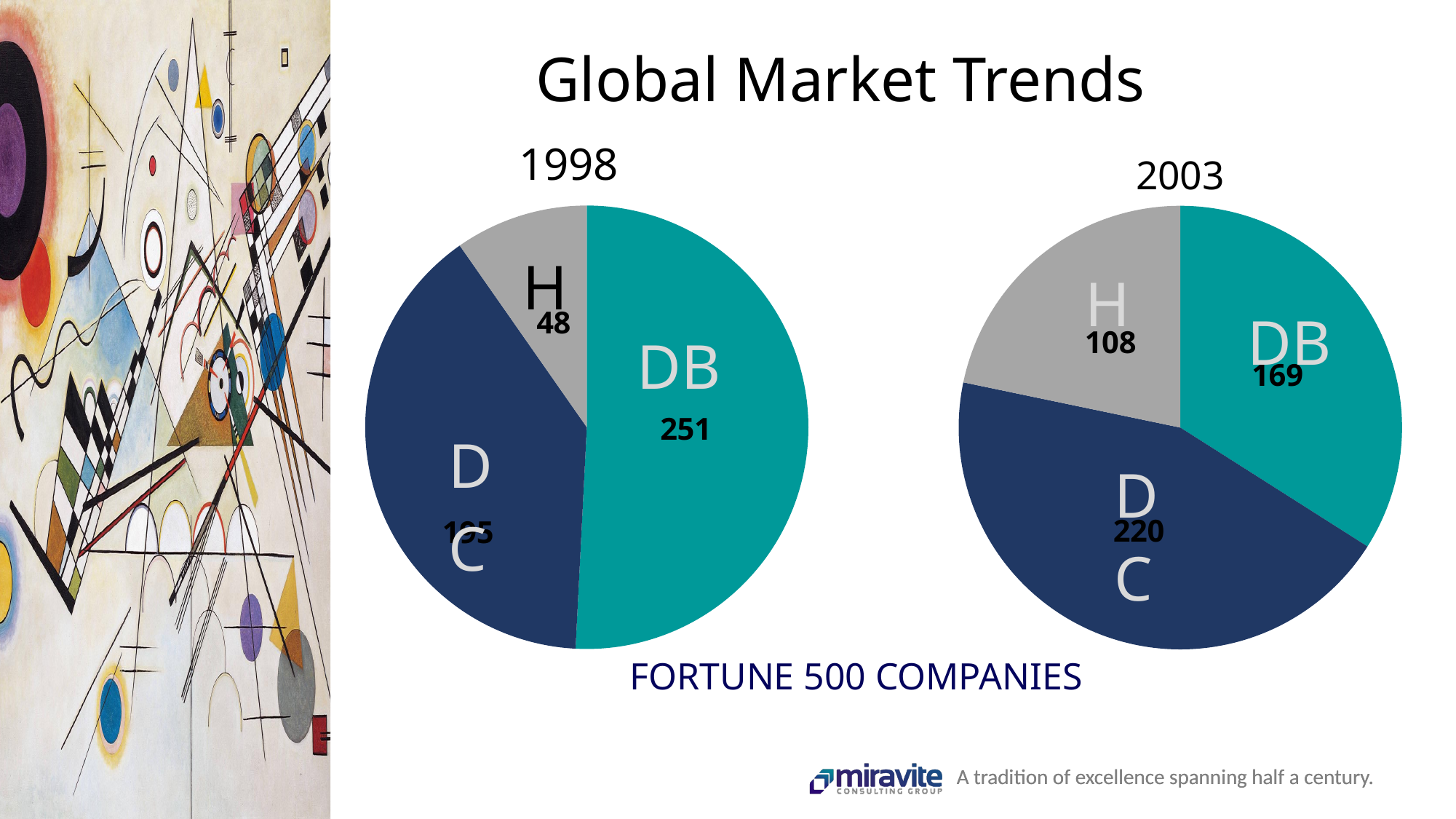
In the 2003 pie chart, which category has the smallest slice? H In the 1998 pie chart, which category has the largest slice? DB In the 1998 pie chart, what is the value for H? 48 Is the value for H larger in the 1998 pie chart or the 2003 pie chart? 2003 In the 2003 pie chart, which category has the largest slice? DC In the 2003 pie chart, what is the value for DB? 169 What type of chart is used for the 1998 and 2003 data? Pie chart In the 2003 pie chart, what is the value for DC? 220 How many slices does the 2003 pie chart have? 3 In the 1998 pie chart, what is the value for DB? 251 In the 2003 pie chart, what is the difference between the values for DC and DB? 51 In the 2003 pie chart, what is the value for H? 108